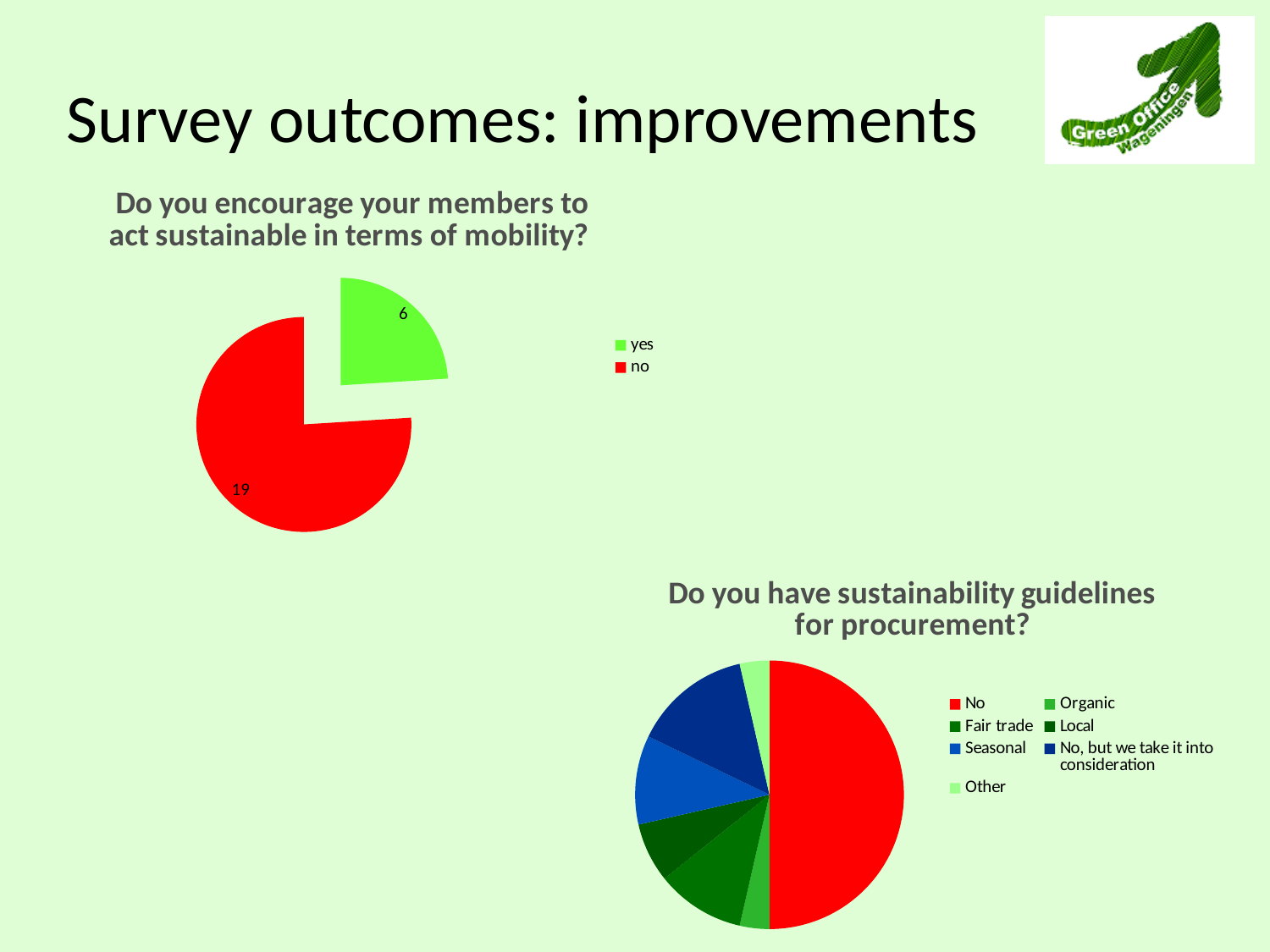
On the chart 'Do you have sustainability guidelines for procurement?', how many categories does the legend list? 7 On the chart 'Do you encourage your members to act sustainable in terms of mobility?', which category has the largest slice? no On the chart 'Do you have sustainability guidelines for procurement?', which category has the largest slice? No On the chart 'Do you encourage your members to act sustainable in terms of mobility?', what is the value for 'no'? 19 On the chart 'Do you encourage your members to act sustainable in terms of mobility?', how many categories are shown? 2 On the chart 'Do you encourage your members to act sustainable in terms of mobility?', what is the difference between the 'no' and 'yes' values? 13 On the chart 'Do you encourage your members to act sustainable in terms of mobility?', what is the value for 'yes'? 6 On the chart 'Do you encourage your members to act sustainable in terms of mobility?', what share of the pie does 'yes' represent? 24% On the chart 'Do you encourage your members to act sustainable in terms of mobility?', what is the total of the two slices? 25 What type of chart is 'Do you have sustainability guidelines for procurement?'? pie chart On the chart 'Do you have sustainability guidelines for procurement?', which slice is larger: 'No' or 'Seasonal'? No